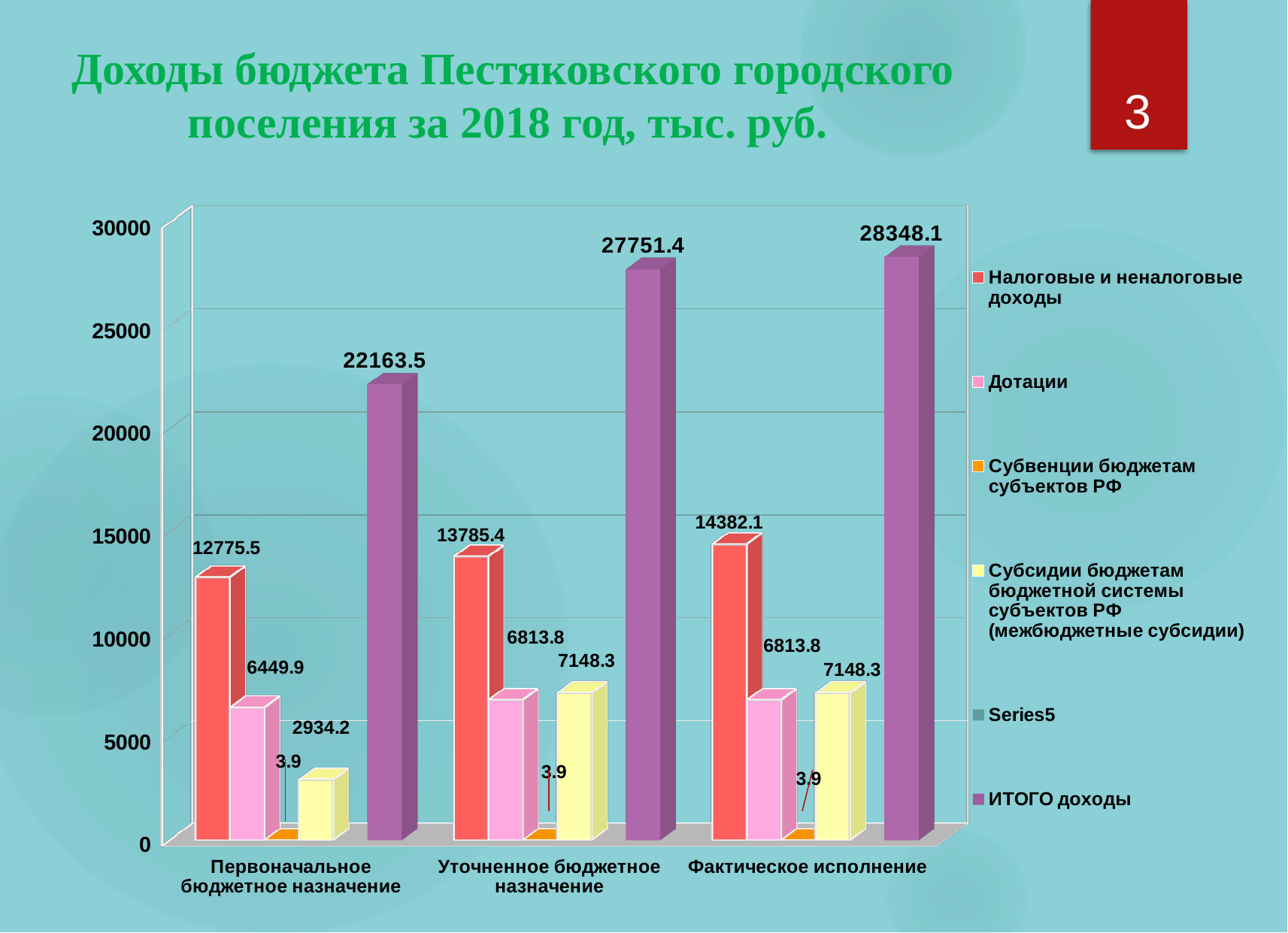
What is the value of Дотации for Первоначальное бюджетное назначение? 6449.9 Which category has the highest value of ИТОГО доходы? Фактическое исполнение Is the value of ИТОГО доходы for Первоначальное бюджетное назначение greater or less than 25000? less What is the value of Субсидии бюджетам бюджетной системы субъектов РФ for Уточненное бюджетное назначение? 7148.3 What is the value of ИТОГО доходы for Фактическое исполнение? 28348.1 Which is larger: Дотации or Субсидии бюджетам бюджетной системы субъектов РФ for Первоначальное бюджетное назначение? Дотации Which category has the lowest value of Субсидии бюджетам бюджетной системы субъектов РФ? Первоначальное бюджетное назначение How many series does the legend list? 6 What is the value of Налоговые и неналоговые доходы for Первоначальное бюджетное назначение? 12775.5 What is the difference between Налоговые и неналоговые доходы for Фактическое исполнение and for Первоначальное бюджетное назначение? 1606.6 How many categories are shown on the x axis? 3 What is the difference between ИТОГО доходы for Фактическое исполнение and for Уточненное бюджетное назначение? 596.7